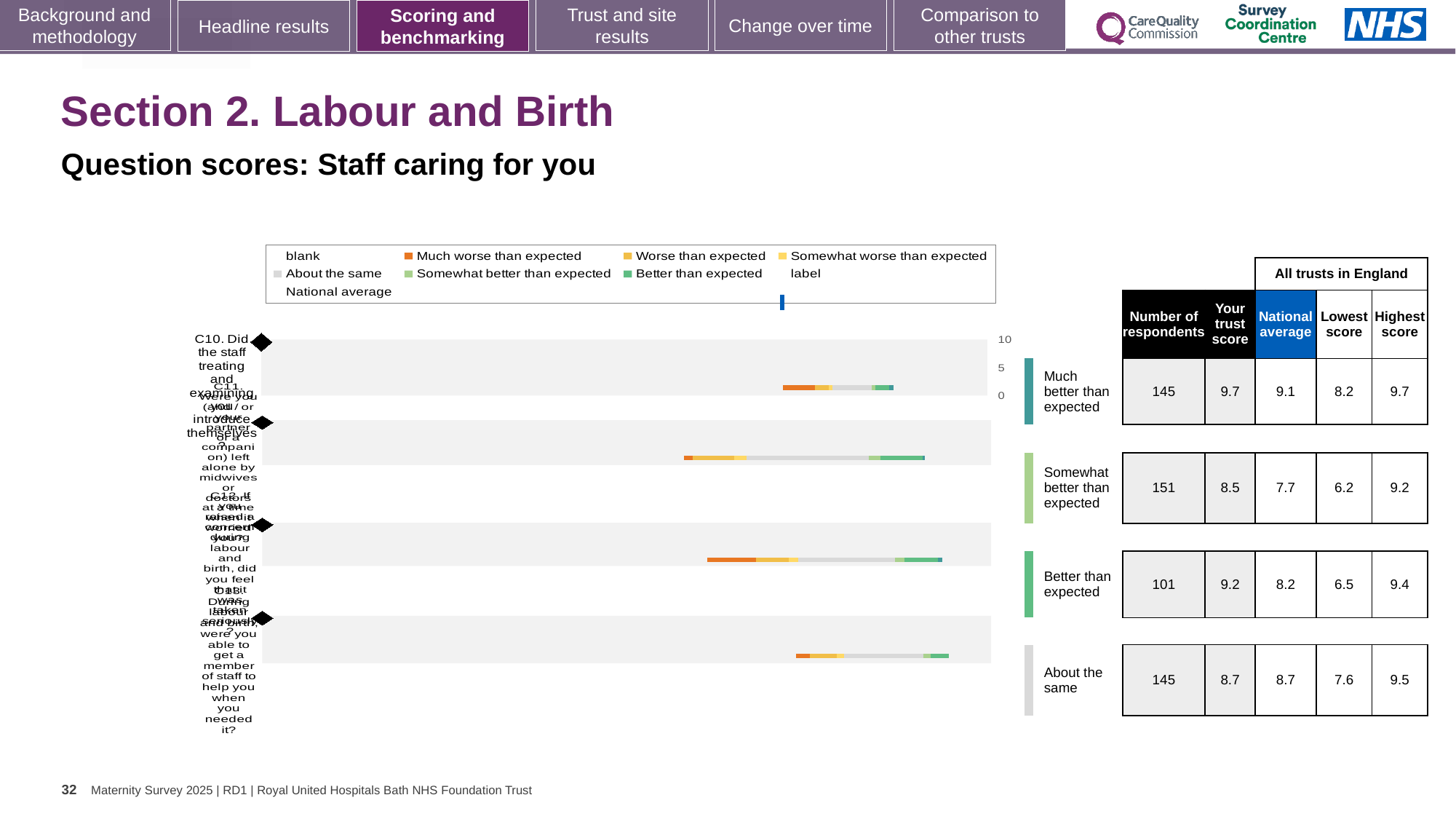
What is the difference between the trust score and the national average for the top row (C10)? 0.6 Is the trust score for the second row (C11) larger or smaller than the trust score for the third row (C12)? smaller How many question rows are plotted in the chart? 4 According to the table beside the chart, how many respondents answered the third row question (C12)? 101 Which benchmark category is the bottom row (C13) assigned to? About the same According to the table beside the chart, what is the lowest score across all trusts for the bottom row (C13)? 7.6 According to the table beside the chart, what is the national average for the second row (C11)? 7.7 Which row has the highest trust score in the table beside the chart? C10 (top row) What kind of chart is shown on the slide? bar chart According to the table beside the chart, what is the trust score for the top row (C10)? 9.7 What is the maximum value shown on the chart's score axis? 10 Which row has the lowest trust score in the table beside the chart? C11 (second row)